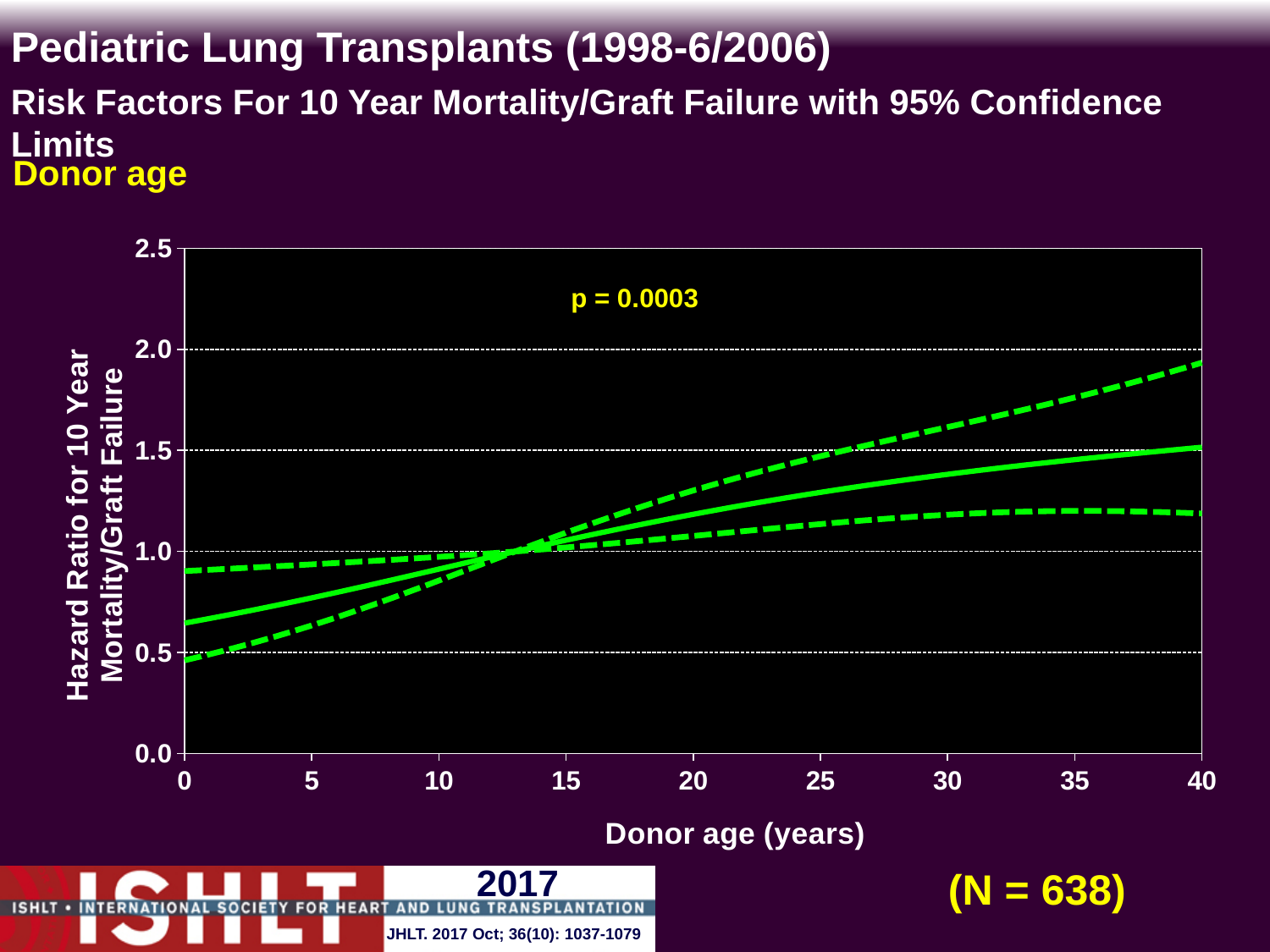
Is the hazard ratio (solid line) at a donor age of 40 years greater or less than 2.0? less Does the solid hazard ratio line rise or fall as donor age increases from 0 to 40 years? rises What is the maximum value shown on the x axis (donor age)? 40 What is the p-value shown on the chart? p = 0.0003 Is the hazard ratio (solid line) at a donor age of 0 years greater or less than 1.0? less Is the upper 95% confidence limit (upper dashed line) at a donor age of 40 years greater or less than 1.5? greater What is the maximum value shown on the y axis? 2.5 What kind of chart is shown on the slide? line chart How many lines are plotted on the chart? 3 What is the sample size (N) shown on the slide? N = 638